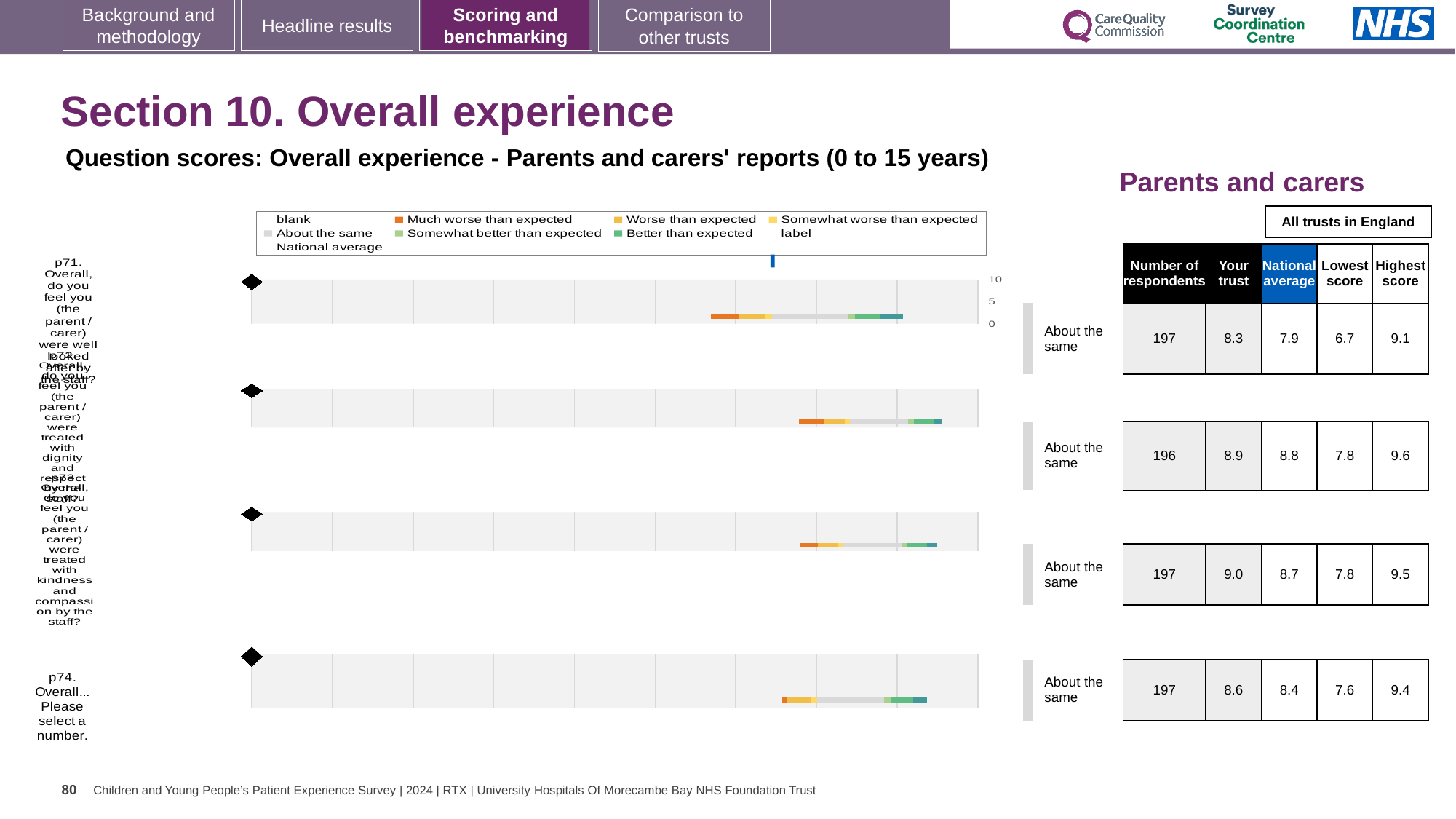
Which question has the highest 'Your trust' score? p73 What is the title of the chart? Question scores: Overall experience - Parents and carers' reports (0 to 15 years) For p73, what is the difference between the 'Your trust' score and the national average? 0.3 What is the 'Your trust' score for p74 (Overall... Please select a number)? 8.6 How many questions (rows) are plotted in the chart? 4 How many respondents answered p72? 196 Which question has the lowest 'Your trust' score? p71 For p72, which is larger: the 'Your trust' score or the national average? Your trust What colour does the legend use for 'Much worse than expected'? orange What is the national average score for p71? 7.9 How many entries does the chart legend list? 9 What kind of chart is used to show the question scores on this slide? bar chart